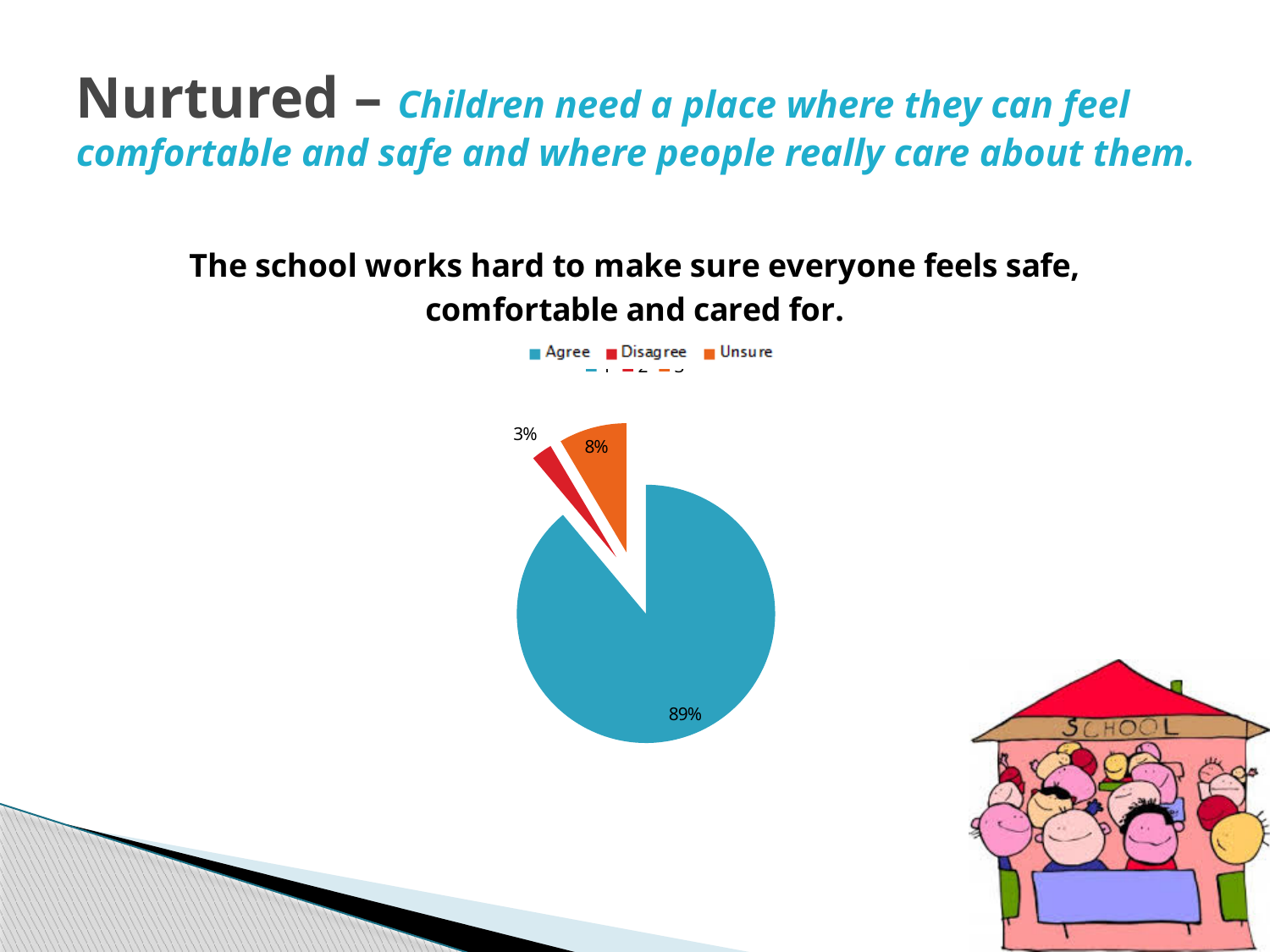
What kind of chart is shown on the slide? pie chart What is the difference in percentage points between Unsure and Disagree? 5 Which is larger, the share for Unsure or the share for Disagree? Unsure What is the difference in percentage points between Agree and Unsure? 81 How many slices does the pie chart have? 3 What percentage of respondents chose Disagree? 3% What percentage of respondents chose Agree? 89% Which response has the largest share of the pie? Agree How many entries does the legend list? 3 What percentage of respondents chose Unsure? 8% Which response has the smallest share of the pie? Disagree What colour is the Agree slice? blue